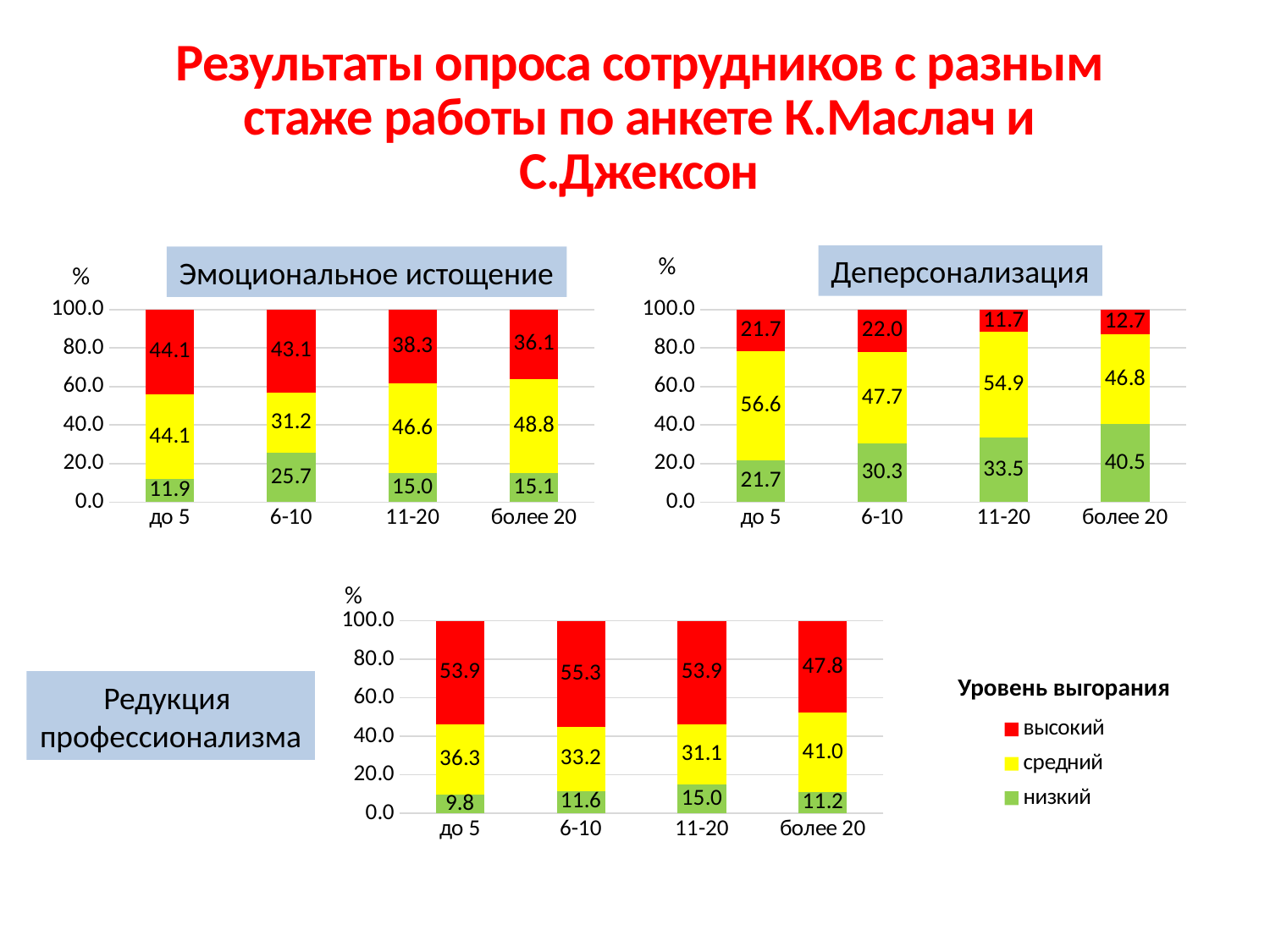
What type of chart is the 'Эмоциональное истощение' chart? stacked bar chart In the 'Редукция профессионализма' chart, which category has the highest 'средний' value? более 20 In the 'Эмоциональное истощение' chart, what is the value of the 'высокий' segment for the 'до 5' category? 44.1 In the 'Эмоциональное истощение' chart, what is the difference between the 'средний' values for 'более 20' and '6-10'? 17.6 In the 'Деперсонализация' chart, which is larger: the 'средний' value for 'до 5' or for '6-10'? до 5 In the 'Эмоциональное истощение' chart, which category has the highest 'низкий' value? 6-10 In the 'Деперсонализация' chart, does the 'низкий' value rise or fall as work experience increases from 'до 5' to 'более 20'? rise In the 'Деперсонализация' chart, which category has the lowest 'высокий' value? 11-20 In the 'Редукция профессионализма' chart, what is the difference between the 'низкий' values for '11-20' and 'до 5'? 5.2 In the 'Деперсонализация' chart, what is the 'низкий' value for the 'более 20' category? 40.5 In the 'Редукция профессионализма' chart, what is the 'высокий' value for the '6-10' category? 55.3 How many series does the legend 'Уровень выгорания' list? 3